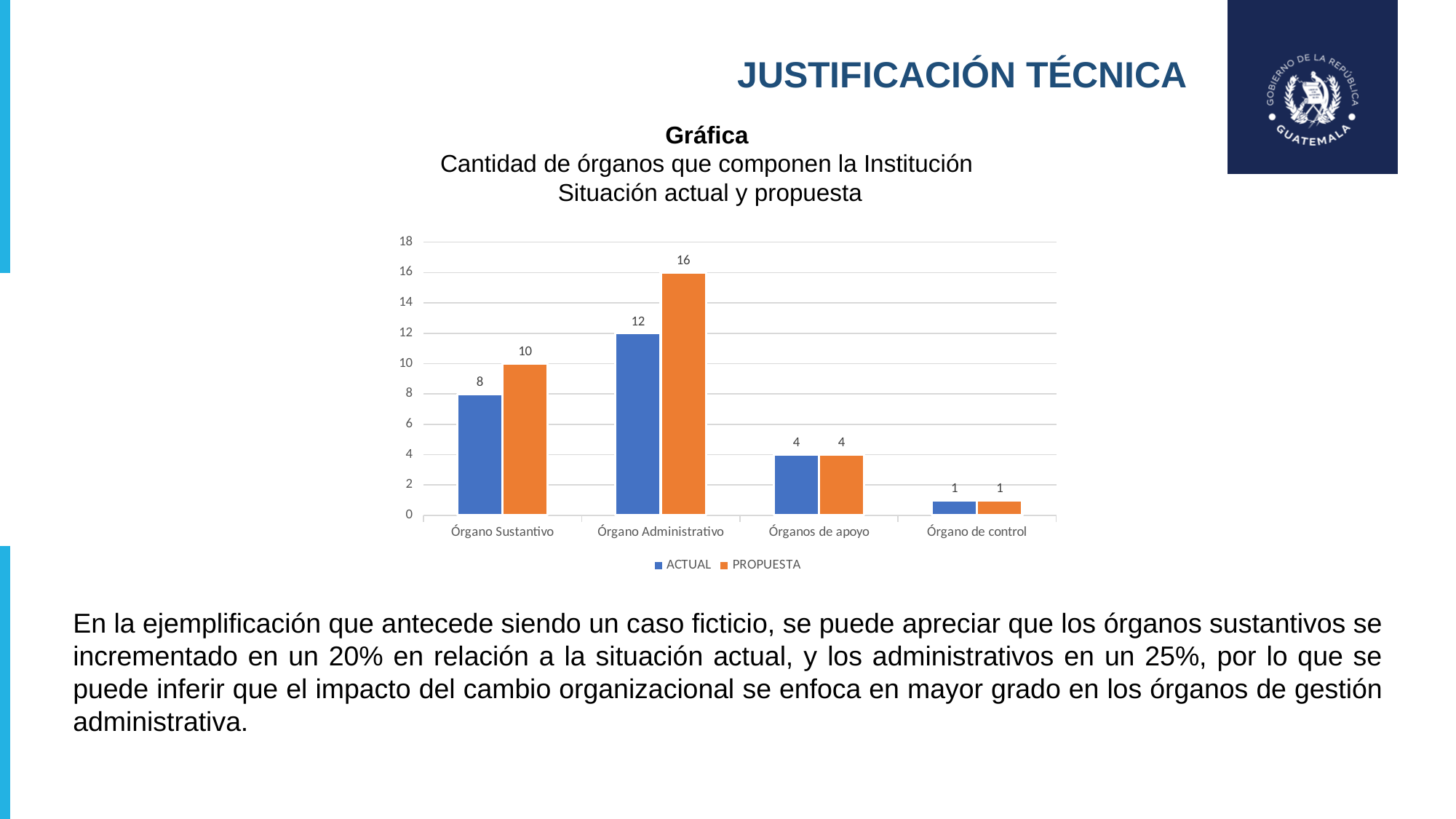
Is the PROPUESTA value for Órgano Administrativo greater or less than 14? greater What is the ACTUAL value for Órgano Administrativo? 12 How many categories are shown on the x axis? 4 What is the difference between the PROPUESTA and ACTUAL values for Órgano Administrativo? 4 How many series does the legend list? 2 What is the PROPUESTA value for Órgano Sustantivo? 10 Which category has the lowest ACTUAL value? Órgano de control What kind of chart is shown on the slide? Bar chart Which colour represents the PROPUESTA series? Orange What is the PROPUESTA value for Órgano de control? 1 Which category has the highest PROPUESTA value? Órgano Administrativo Which is larger for Órgano Sustantivo, the ACTUAL value or the PROPUESTA value? PROPUESTA